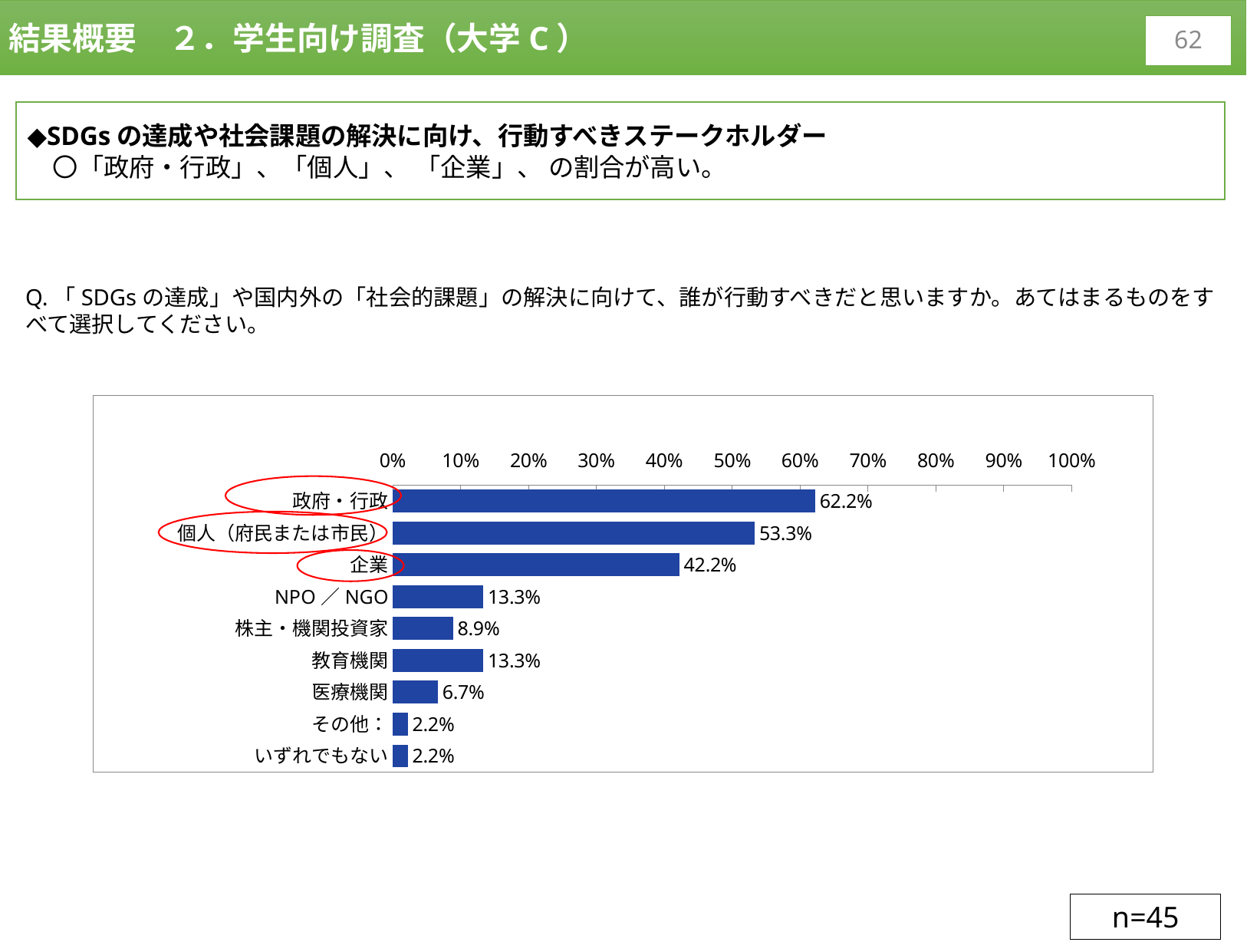
What is the value for 個人（府民または市民）? 53.3% What is the difference between the values for 企業 and NPO／NGO? 28.9% Which is larger, the value for 教育機関 or the value for 医療機関? 教育機関 Which category has the highest value? 政府・行政 Is the value for 企業 greater or less than 40%? greater What is the value for 株主・機関投資家? 8.9% What is the difference between the values for 政府・行政 and 個人（府民または市民）? 8.9% What kind of chart is shown on the slide? bar chart How many categories are shown in the chart? 9 What is the value for 医療機関? 6.7% What is the value for 企業? 42.2% What is the value for 政府・行政? 62.2%